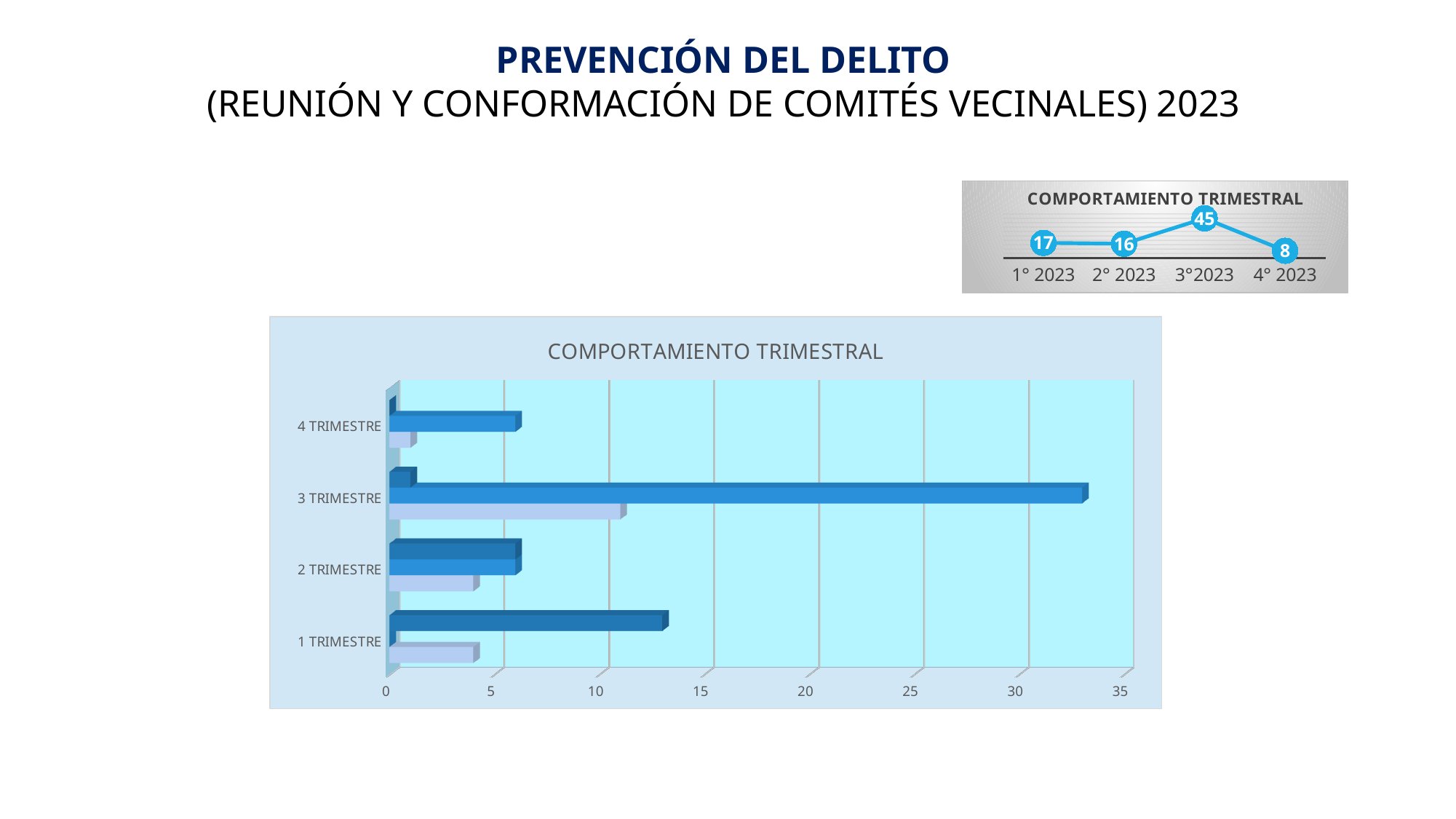
In the large bar chart, which category has the longest bar? 3 TRIMESTRE In the line chart at the top right, what is the value for 4° 2023? 8 In the line chart at the top right, which quarter has the highest value? 3°2023 In the line chart at the top right, is the value for 2° 2023 larger or smaller than the value for 1° 2023? smaller In the large bar chart, is the longest bar for 3 TRIMESTRE greater or less than 30? greater In the line chart at the top right, what is the value for 1° 2023? 17 In the line chart at the top right, which quarter has the lowest value? 4° 2023 In the large bar chart, how many categories are shown on the vertical axis? 4 What kind of chart is the large chart in the lower part of the slide? bar chart In the line chart at the top right, how many data points are plotted? 4 In the line chart at the top right, what is the value for 3°2023? 45 In the line chart at the top right, what is the difference between the values for 3°2023 and 4° 2023? 37